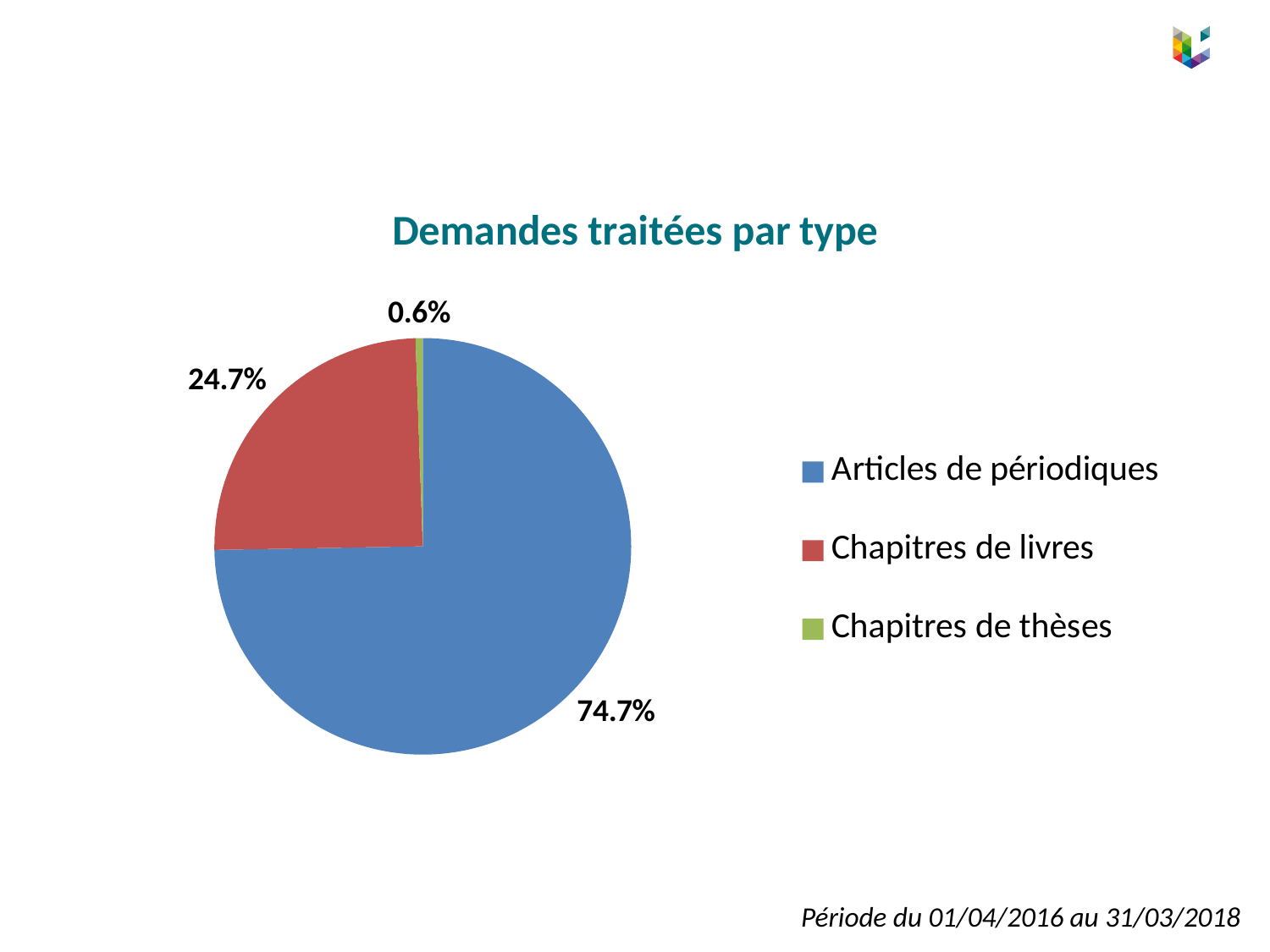
What type of chart is shown on the slide? pie chart Which is larger, the share for Chapitres de livres or the share for Chapitres de thèses? Chapitres de livres What share of the pie is Articles de périodiques? 74.7% How many categories does the pie chart show? 3 What is the difference in percentage points between Articles de périodiques and Chapitres de livres? 50 percentage points What colour is the slice for Chapitres de livres? red What is the difference in percentage points between Chapitres de livres and Chapitres de thèses? 24.1 percentage points What share of the pie is Chapitres de livres? 24.7% Which category has the largest slice of the pie? Articles de périodiques Which category has the smallest slice of the pie? Chapitres de thèses What is the title of the chart? Demandes traitées par type What share of the pie is Chapitres de thèses? 0.6%